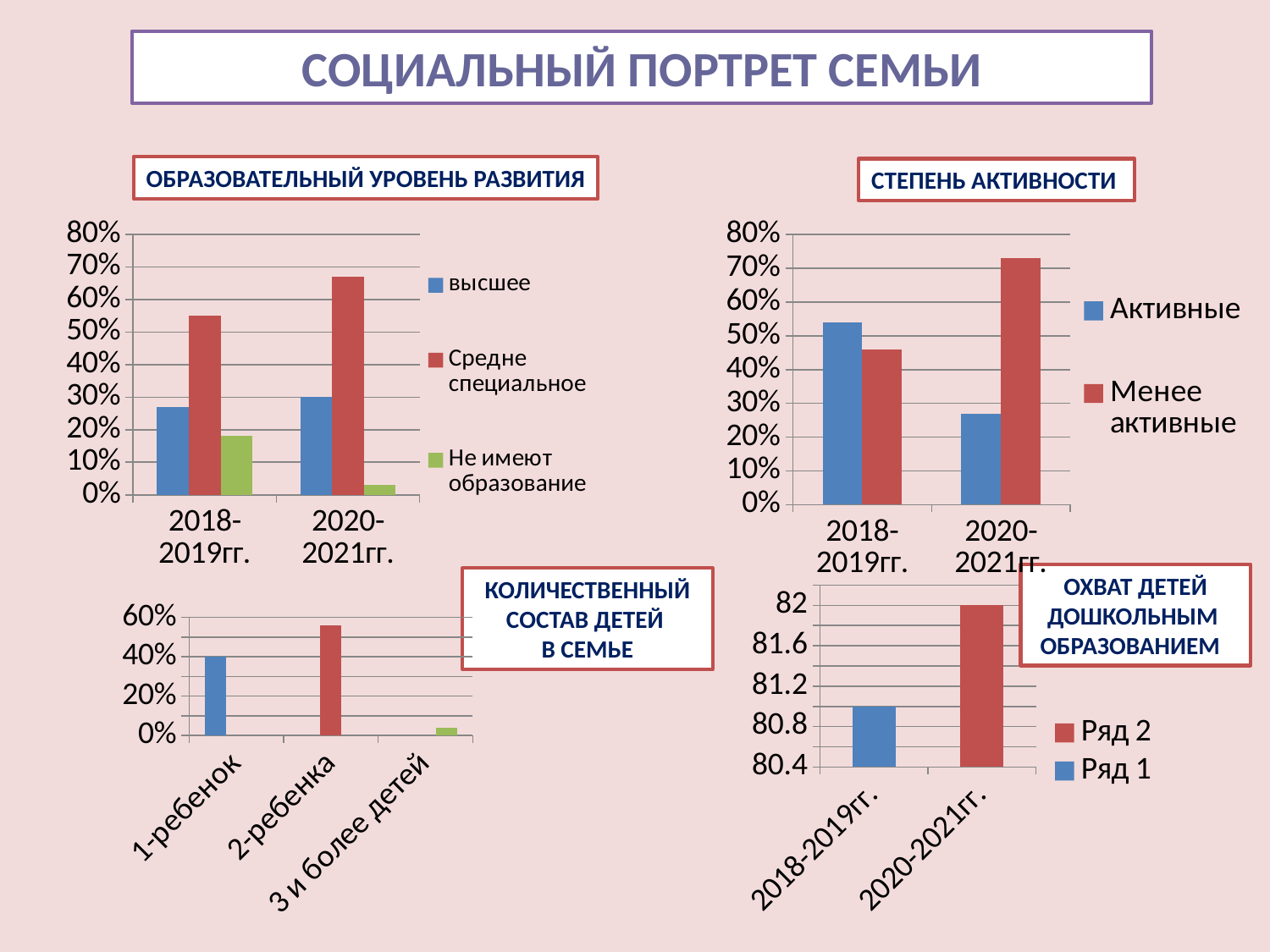
In the chart titled «ОБРАЗОВАТЕЛЬНЫЙ УРОВЕНЬ РАЗВИТИЯ», how many series does the legend list? 3 In the chart titled «СТЕПЕНЬ АКТИВНОСТИ», which series is larger for 2018-2019гг.: «Активные» or «Менее активные»? Активные In the chart titled «ОБРАЗОВАТЕЛЬНЫЙ УРОВЕНЬ РАЗВИТИЯ», is the value for «Средне специальное» in 2020-2021гг. greater or less than 60%? greater In the chart titled «СТЕПЕНЬ АКТИВНОСТИ», does the value for «Активные» rise or fall from 2018-2019гг. to 2020-2021гг.? fall In the chart titled «ОХВАТ ДЕТЕЙ ДОШКОЛЬНЫМ ОБРАЗОВАНИЕМ», is the value for 2018-2019гг. greater or less than 81.2? less In the chart titled «ОБРАЗОВАТЕЛЬНЫЙ УРОВЕНЬ РАЗВИТИЯ», is the value for «Не имеют образование» in 2018-2019гг. greater or less than 20%? less What kind of chart is the one titled «ОХВАТ ДЕТЕЙ ДОШКОЛЬНЫМ ОБРАЗОВАНИЕМ»? bar chart In the chart titled «ОБРАЗОВАТЕЛЬНЫЙ УРОВЕНЬ РАЗВИТИЯ», which series has the highest value for 2020-2021гг.? Средне специальное In the chart titled «КОЛИЧЕСТВЕННЫЙ СОСТАВ ДЕТЕЙ В СЕМЬЕ», which category has the highest value? 2-ребенка In the chart titled «КОЛИЧЕСТВЕННЫЙ СОСТАВ ДЕТЕЙ В СЕМЬЕ», how many categories are shown on the x axis? 3 In the chart titled «КОЛИЧЕСТВЕННЫЙ СОСТАВ ДЕТЕЙ В СЕМЬЕ», which category has the lowest value? 3 и более детей